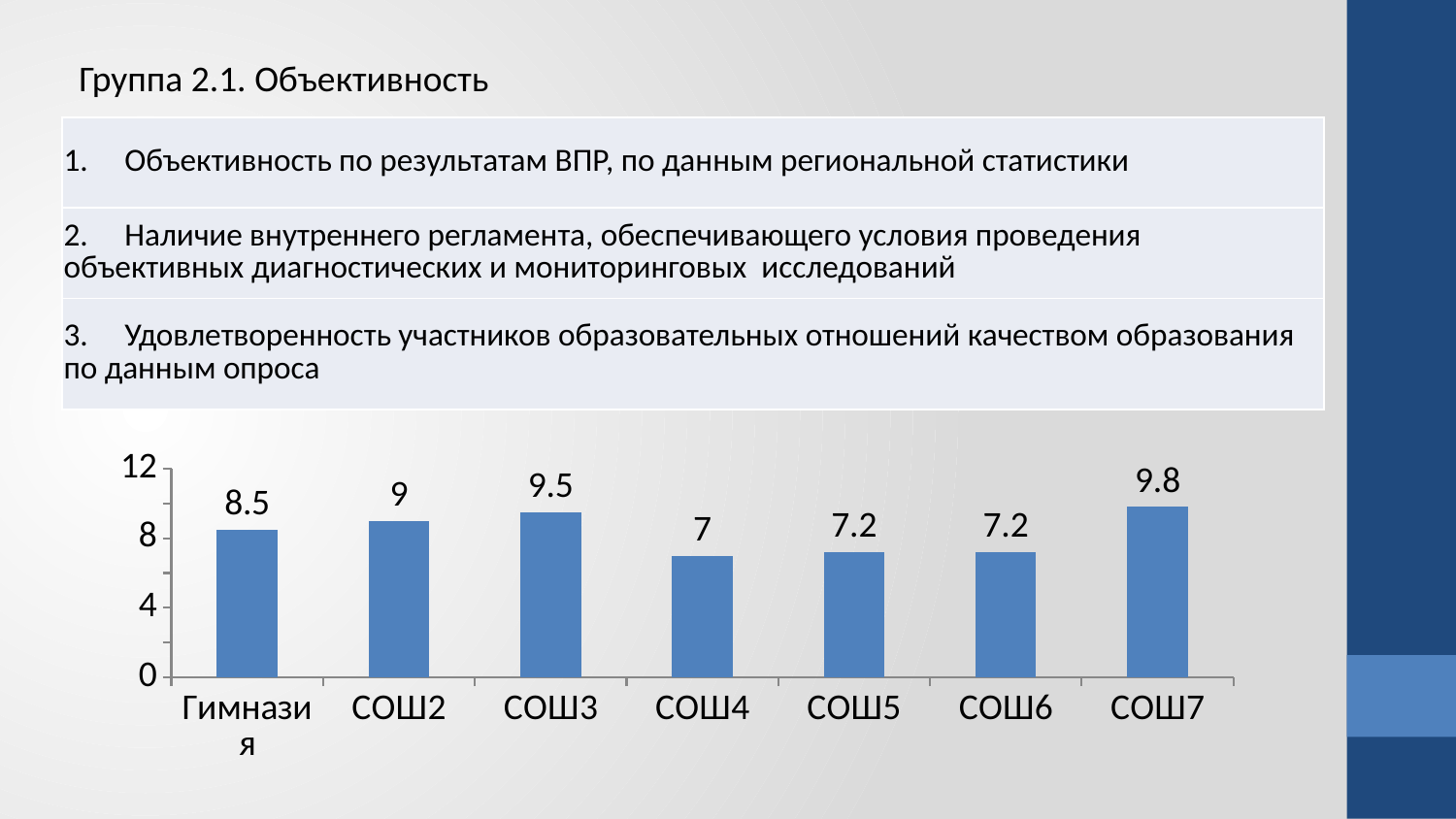
Which category has the highest value? СОШ7 Which two categories share the same value of 7.2? СОШ5 and СОШ6 What kind of chart is shown on the slide? bar chart What is the value for Гимназия? 8.5 Which category has the lowest value? СОШ4 Which is larger, the value for СОШ2 or the value for СОШ5? СОШ2 What is the value for СОШ3? 9.5 What is the difference between the values for СОШ7 and СОШ4? 2.8 Is the value for СОШ6 greater or less than 8? less How many categories are shown on the x axis? 7 What is the value for СОШ4? 7 What is the difference between the values for СОШ3 and Гимназия? 1